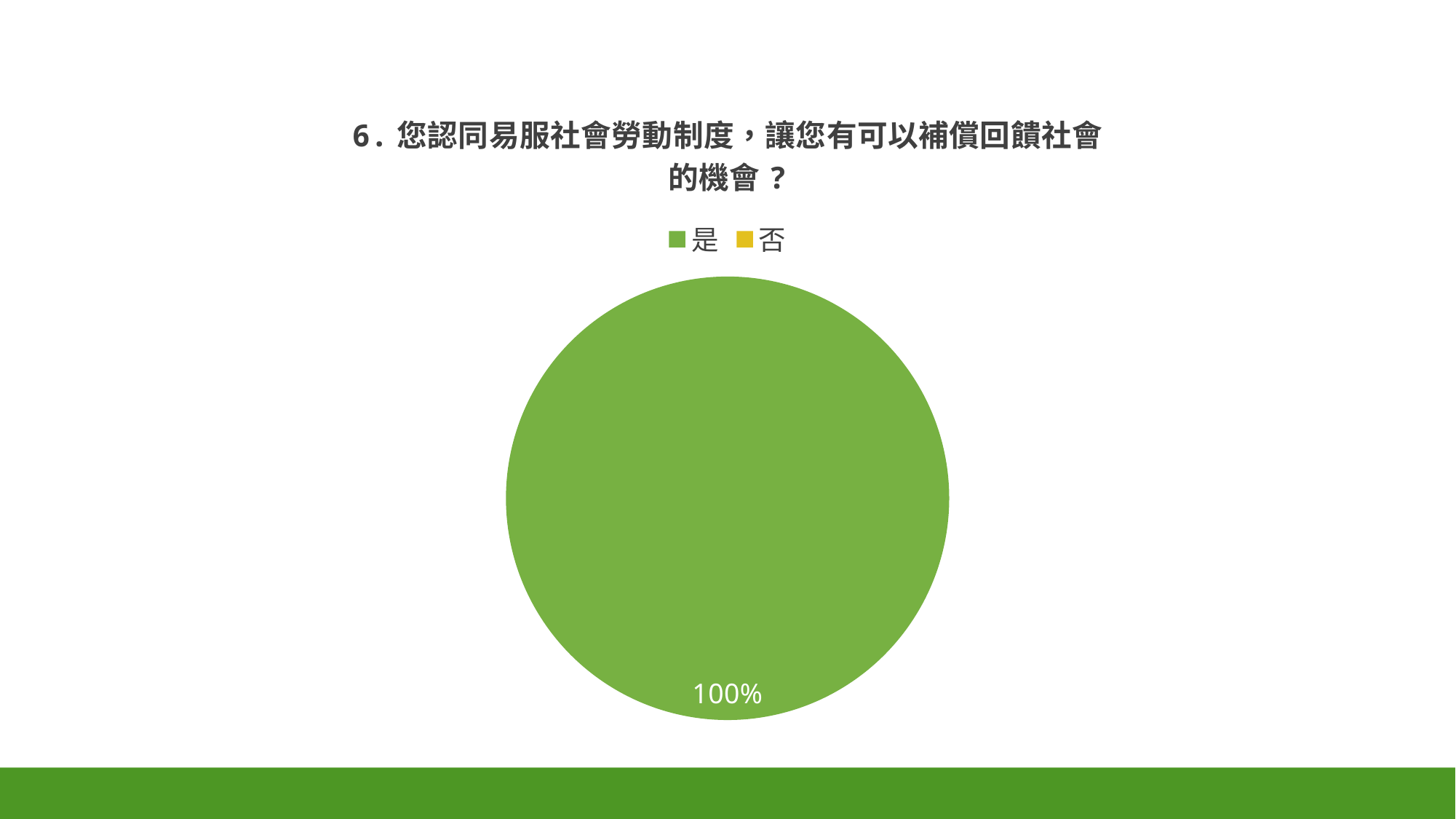
What are the two legend entries of the pie chart? 是 and 否 What colour represents 是 in the pie chart? green What kind of chart is shown on the slide? pie chart What is the only data label printed on the pie chart? 100% What share of the pie does 是 account for? 100% Is the share for 是 greater or less than 50%? greater How many entries does the legend list? 2 Does the 否 category have a visible slice in the pie? No Which is larger, the share for 是 or the share for 否? 是 Which category has the largest share of the pie? 是